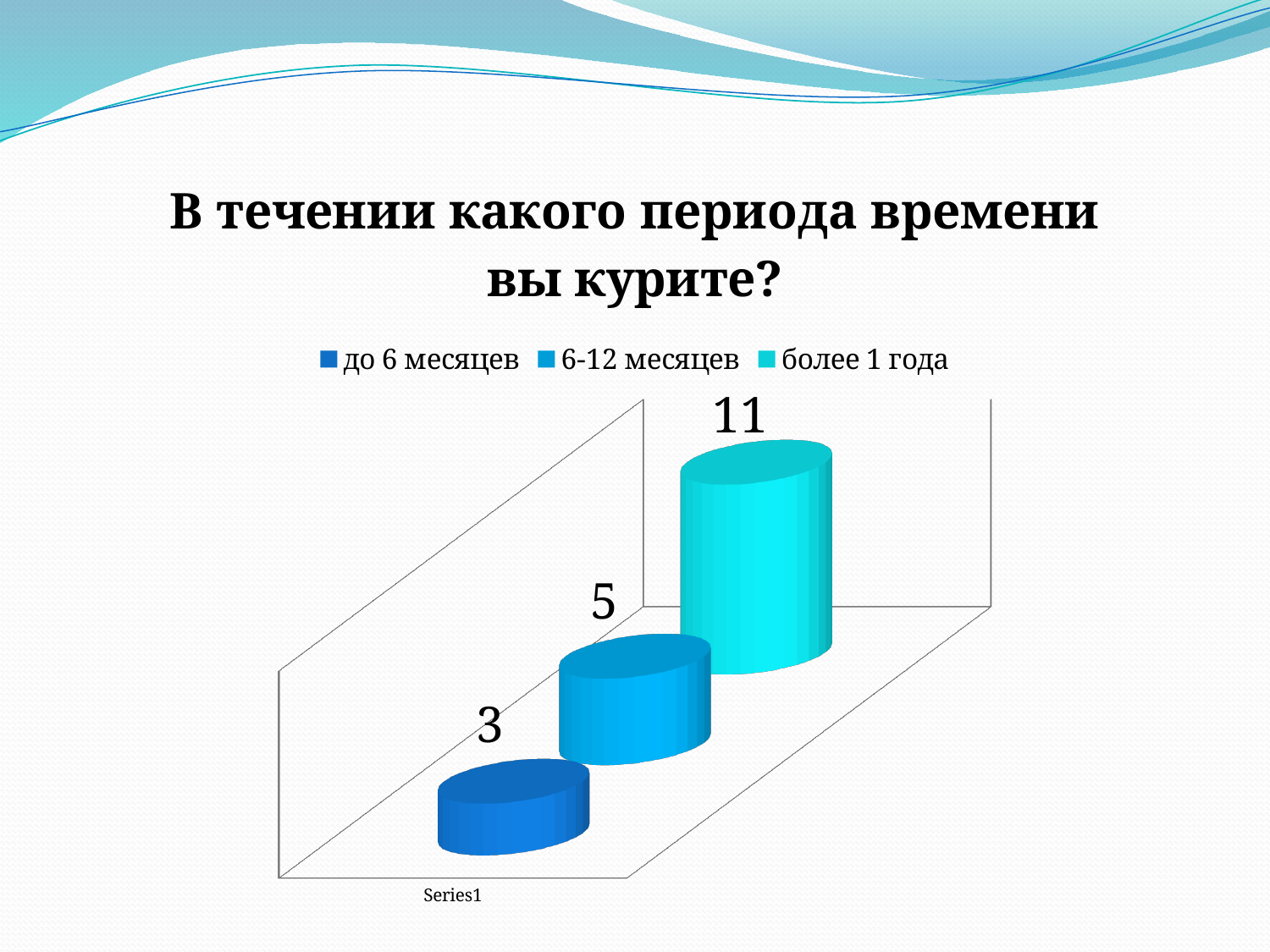
What is the total of the three values shown in the chart? 19 Which category has the lowest value? до 6 месяцев What is the title of the chart? В течении какого периода времени вы курите? What is the value for "более 1 года"? 11 What kind of chart is shown on the slide? bar chart Which is larger, the value for "до 6 месяцев" or the value for "6-12 месяцев"? 6-12 месяцев How many entries does the legend list? 3 What is the difference between the values for "более 1 года" and "6-12 месяцев"? 6 What is the difference between the values for "6-12 месяцев" and "до 6 месяцев"? 2 What is the value for "6-12 месяцев"? 5 Which category has the highest value? более 1 года What is the value for "до 6 месяцев"? 3